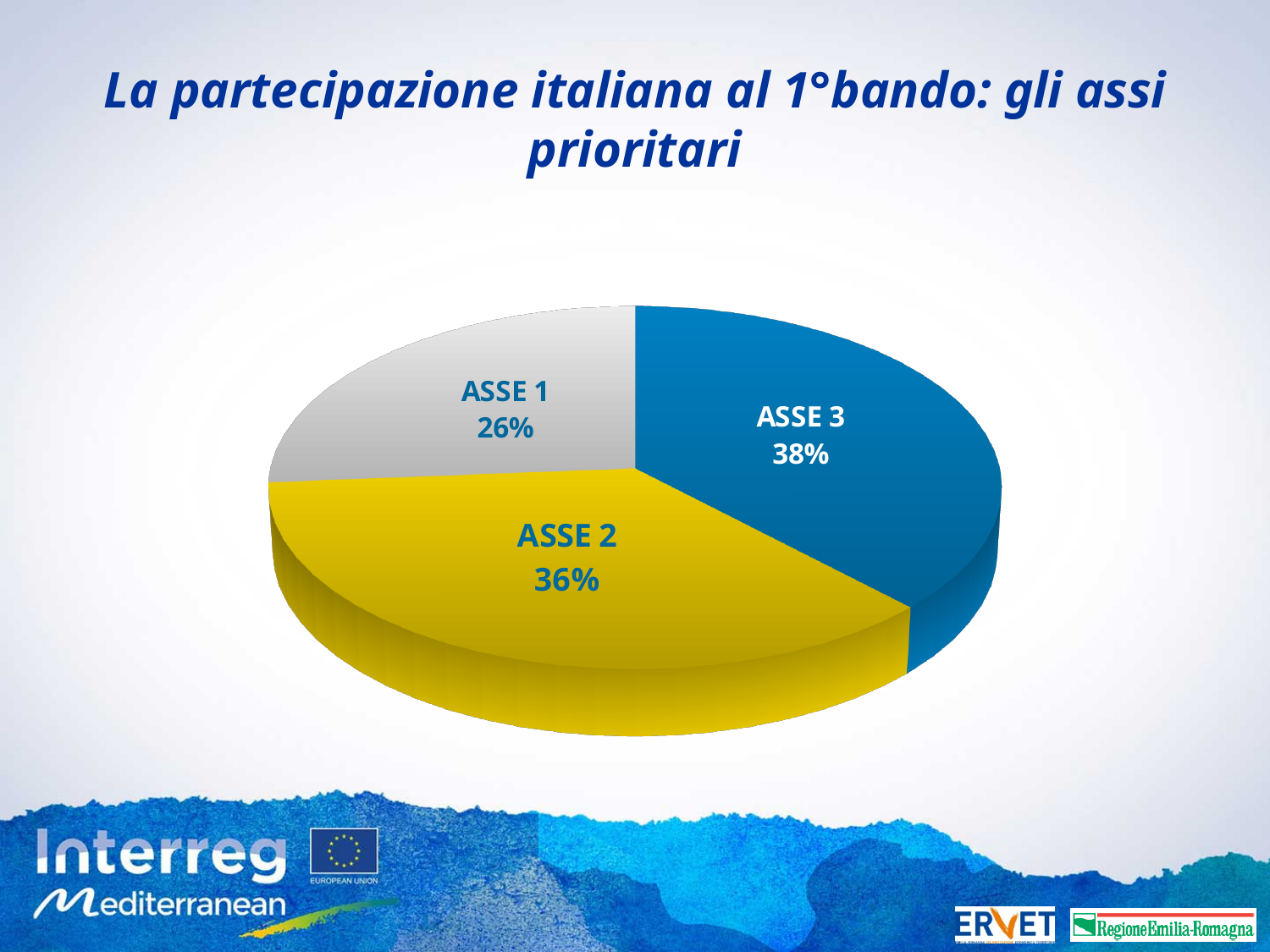
Which slice of the pie is the smallest? ASSE 1 What is the difference in percentage points between ASSE 3 and ASSE 1? 12 Which slice of the pie is the largest? ASSE 3 What colour is the ASSE 2 slice? Yellow What is the title of the slide containing the chart? La partecipazione italiana al 1°bando: gli assi prioritari Which is larger, the share for ASSE 2 or the share for ASSE 1? ASSE 2 What share of the pie does ASSE 3 represent? 38% What is the difference in percentage points between ASSE 2 and ASSE 1? 10 How many slices does the pie chart have? 3 What kind of chart is shown on the slide? Pie chart What share of the pie does ASSE 1 represent? 26% What share of the pie does ASSE 2 represent? 36%